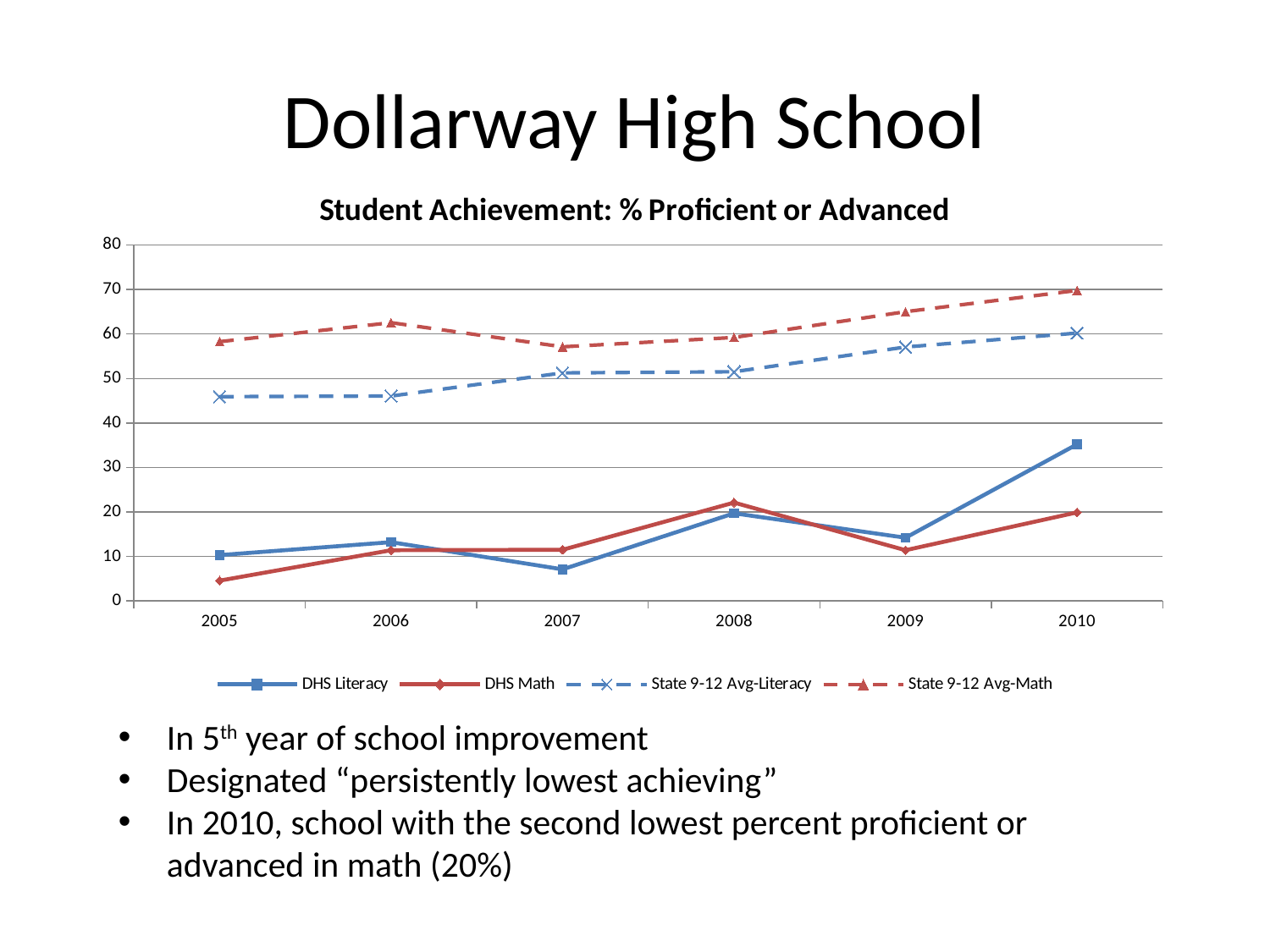
How many years are plotted along the x axis? 6 In which year is DHS Math at its lowest? 2005 In 2010, which is larger: State 9-12 Avg-Math or State 9-12 Avg-Literacy? State 9-12 Avg-Math Is the value for DHS Literacy in 2010 greater or less than 30? greater Is the value for DHS Math in 2005 greater or less than 10? less What kind of chart is shown on the slide? line chart In which year is DHS Literacy at its highest? 2010 Which series has the highest value in 2010? State 9-12 Avg-Math Does State 9-12 Avg-Literacy rise or fall from 2007 to 2010? rise In which year is DHS Literacy at its lowest? 2007 How many series does the legend list? 4 What is the title of the chart? Student Achievement: % Proficient or Advanced